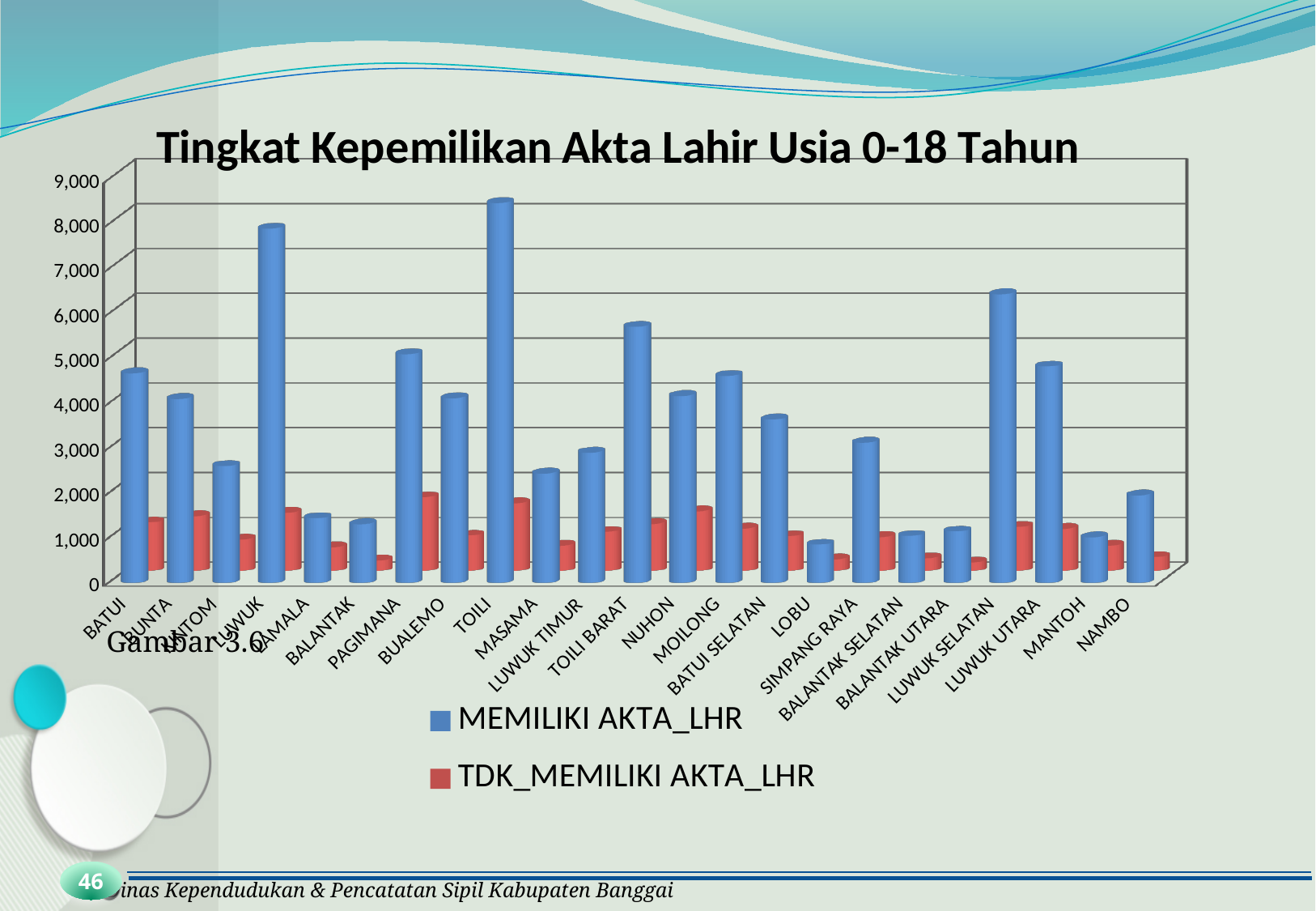
How many series does the legend list? 2 Which category has the highest value for MEMILIKI AKTA_LHR? TOILI How many categories are shown on the x axis of the chart? 23 Is the MEMILIKI AKTA_LHR value for LOBU greater or less than 1,000? less Is the MEMILIKI AKTA_LHR value for TOILI greater or less than 8,000? greater Which category has the highest value for TDK_MEMILIKI AKTA_LHR? PAGIMANA Which has the larger MEMILIKI AKTA_LHR value, BUALEMO or MASAMA? BUALEMO What kind of chart is shown on the slide? bar chart Which has the larger MEMILIKI AKTA_LHR value, LUWUK or LUWUK SELATAN? LUWUK Is the MEMILIKI AKTA_LHR value for LUWUK SELATAN greater or less than 6,000? greater What is the title of the chart? Tingkat Kepemilikan Akta Lahir Usia 0-18 Tahun